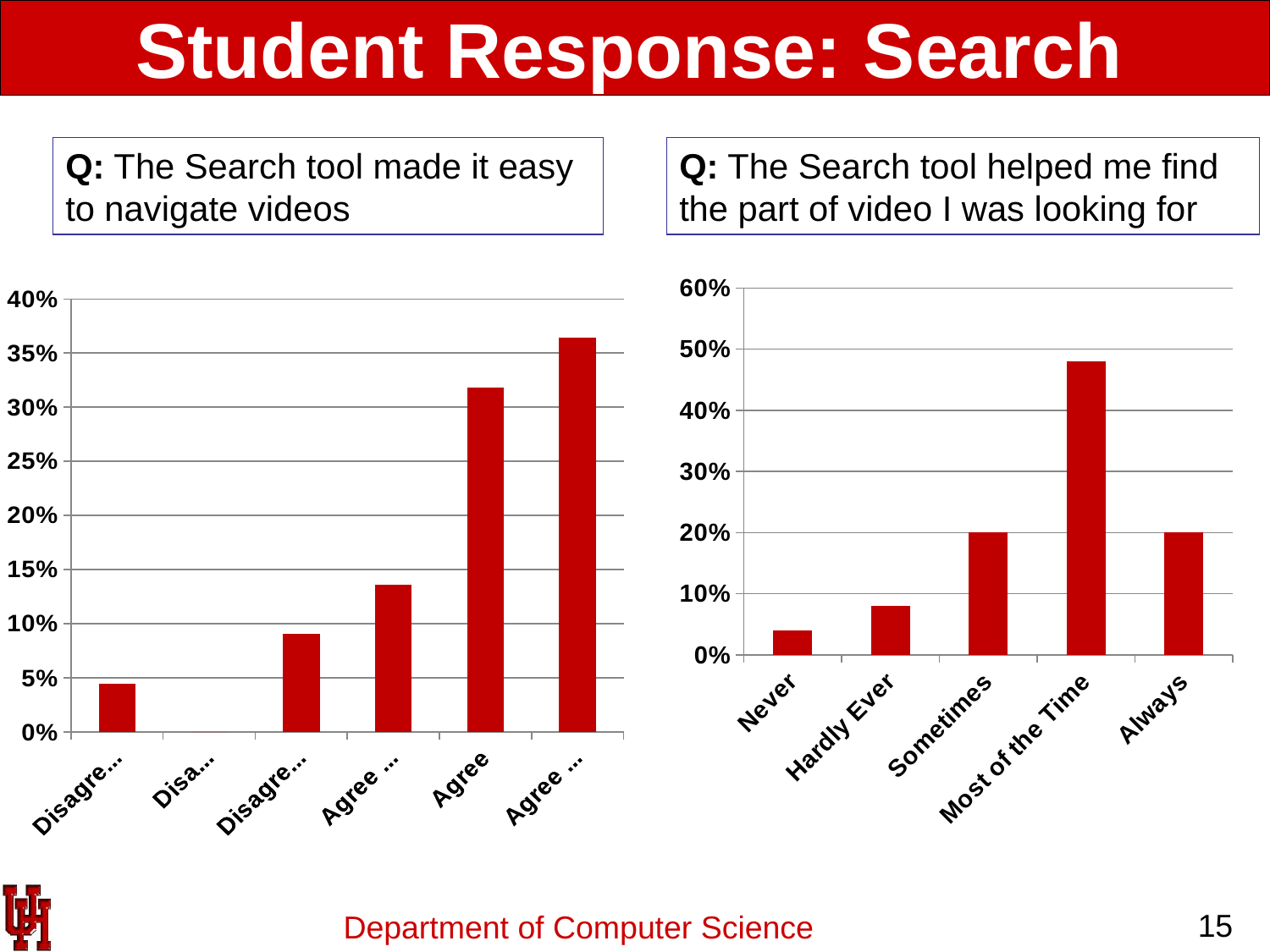
On the right chart (The Search tool helped me find the part of video I was looking for), what is the value for Always? 20% On the right chart (The Search tool helped me find the part of video I was looking for), is the value for Never greater or less than 10%? less On the left chart (The Search tool made it easy to navigate videos), is the value for Agree greater or less than 30%? greater On the left chart (The Search tool made it easy to navigate videos), do the values generally rise or fall from left to right along the x axis? rise On the right chart (The Search tool helped me find the part of video I was looking for), which is larger: Hardly Ever or Sometimes? Sometimes What kind of chart is the left chart (The Search tool made it easy to navigate videos)? bar chart On the right chart (The Search tool helped me find the part of video I was looking for), is the value for Most of the Time greater or less than 40%? greater On the right chart (The Search tool helped me find the part of video I was looking for), what is the value for Sometimes? 20% On the right chart (The Search tool helped me find the part of video I was looking for), which category has the lowest value? Never How many categories are shown on the right chart (The Search tool helped me find the part of video I was looking for)? 5 On the right chart (The Search tool helped me find the part of video I was looking for), which category has the highest value? Most of the Time How many categories are shown on the left chart (The Search tool made it easy to navigate videos)? 6